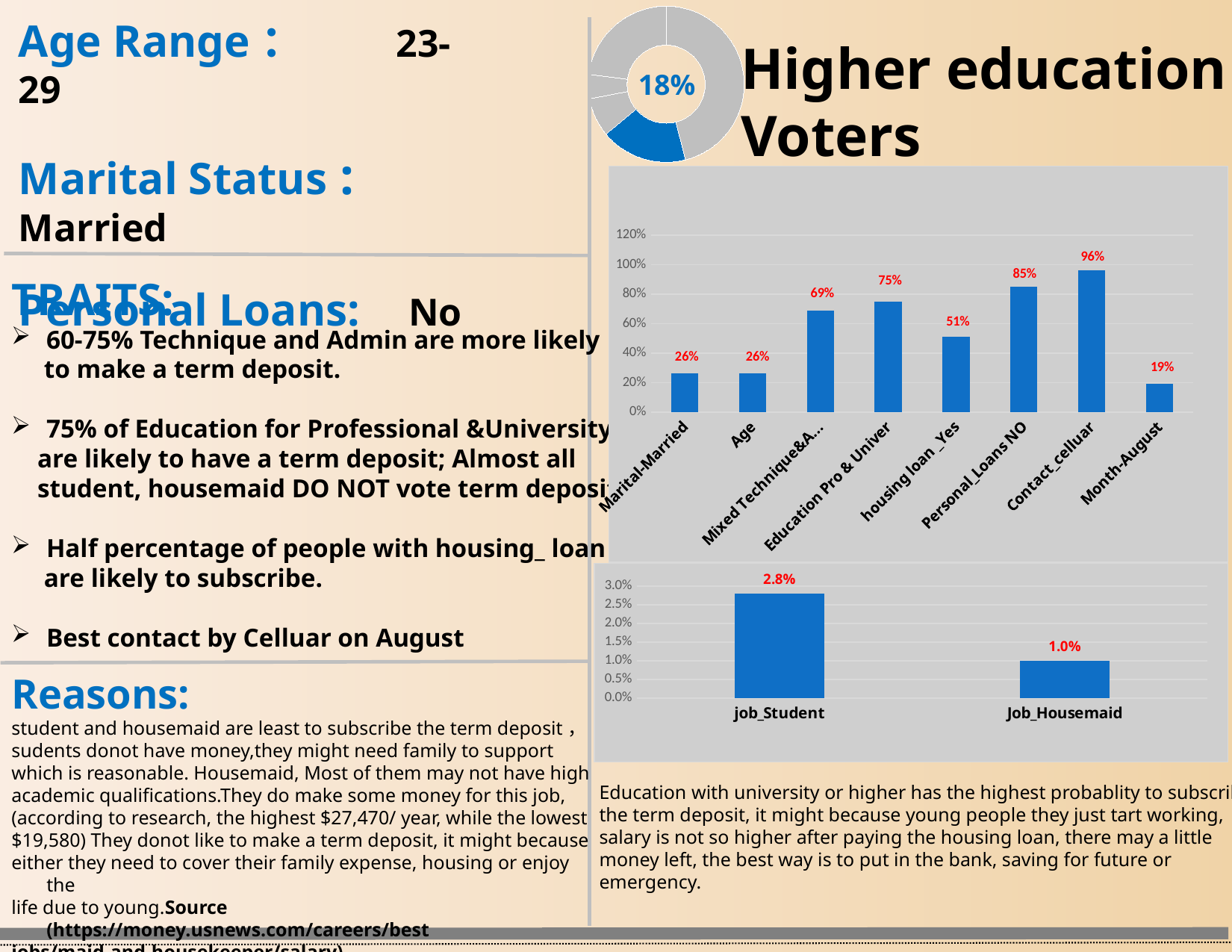
In the donut chart at the top of the slide, what share does the blue slice represent? 18% In the lower bar chart, what is the difference between job_Student and Job_Housemaid? 1.8% In the lower bar chart, what is the value for job_Student? 2.8% In the upper bar chart, which category has the highest value? Contact_celluar In the upper bar chart, what is the difference between Personal_Loans NO and Education Pro & Univer? 10% In the upper bar chart, which is larger, the value for Age or the value for Month-August? Age In the upper bar chart, is the value for Personal_Loans NO greater or less than 80%? greater In the upper bar chart, which category has the lowest value? Month-August In the upper bar chart, what is the value for housing loan_Yes? 51% In the upper bar chart, what is the value for Contact_celluar? 96% What kind of chart is the lower chart showing job_Student and Job_Housemaid? Bar chart How many categories are shown in the upper bar chart? 8